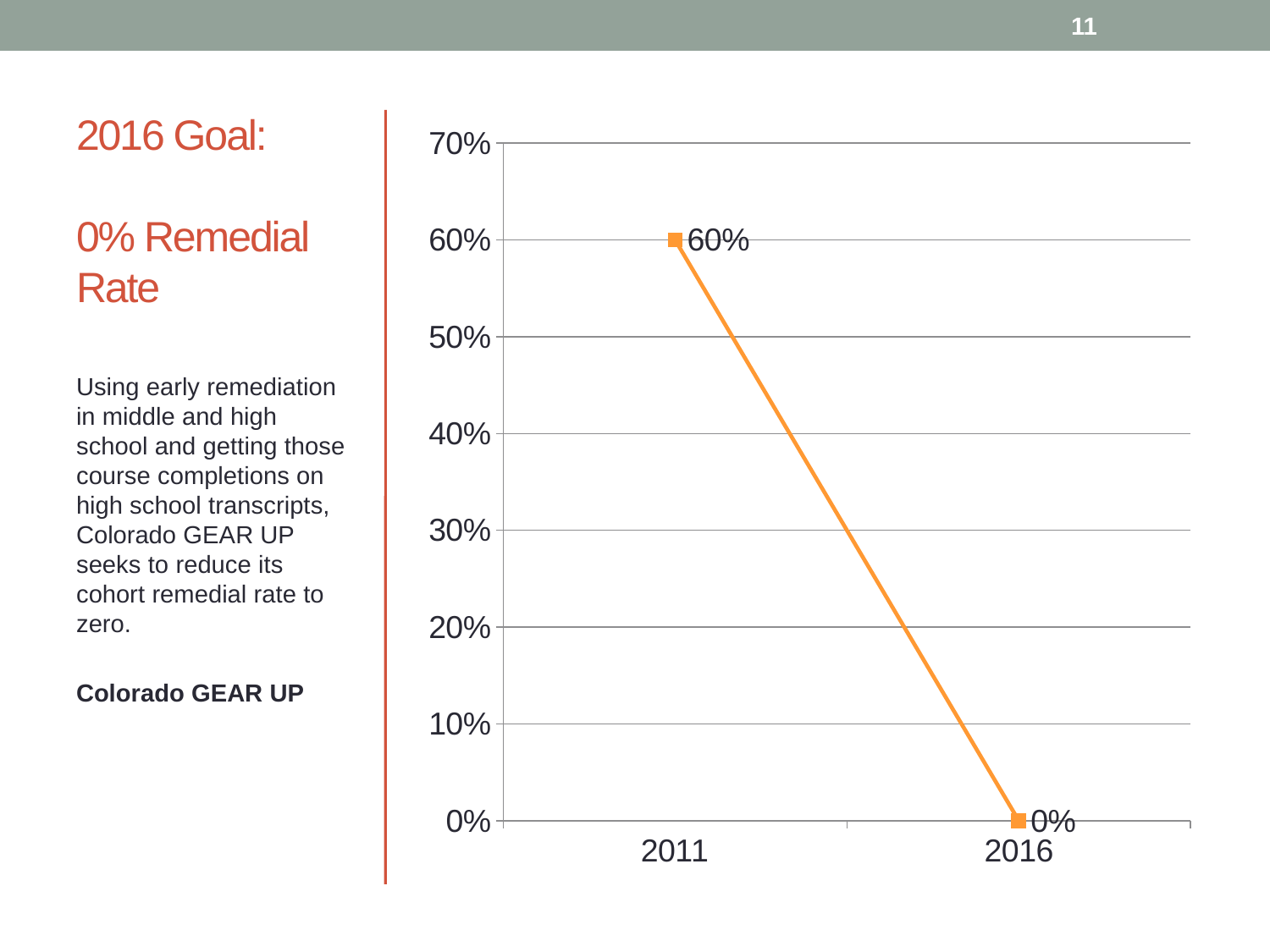
How many data points are plotted on the chart? 2 What colour is the line on the chart? orange Which year has the lowest value? 2016 What is the difference between the 2011 value and the 2016 value? 60% What kind of chart is shown on the slide? line chart What is the value for 2016? 0% Do the values rise or fall from 2011 to 2016? fall Which is larger, the value for 2011 or the value for 2016? 2011 Is the value for 2011 greater or less than 50%? greater Which year has the highest value? 2011 What is the highest value shown on the vertical axis? 70% What is the value for 2011? 60%